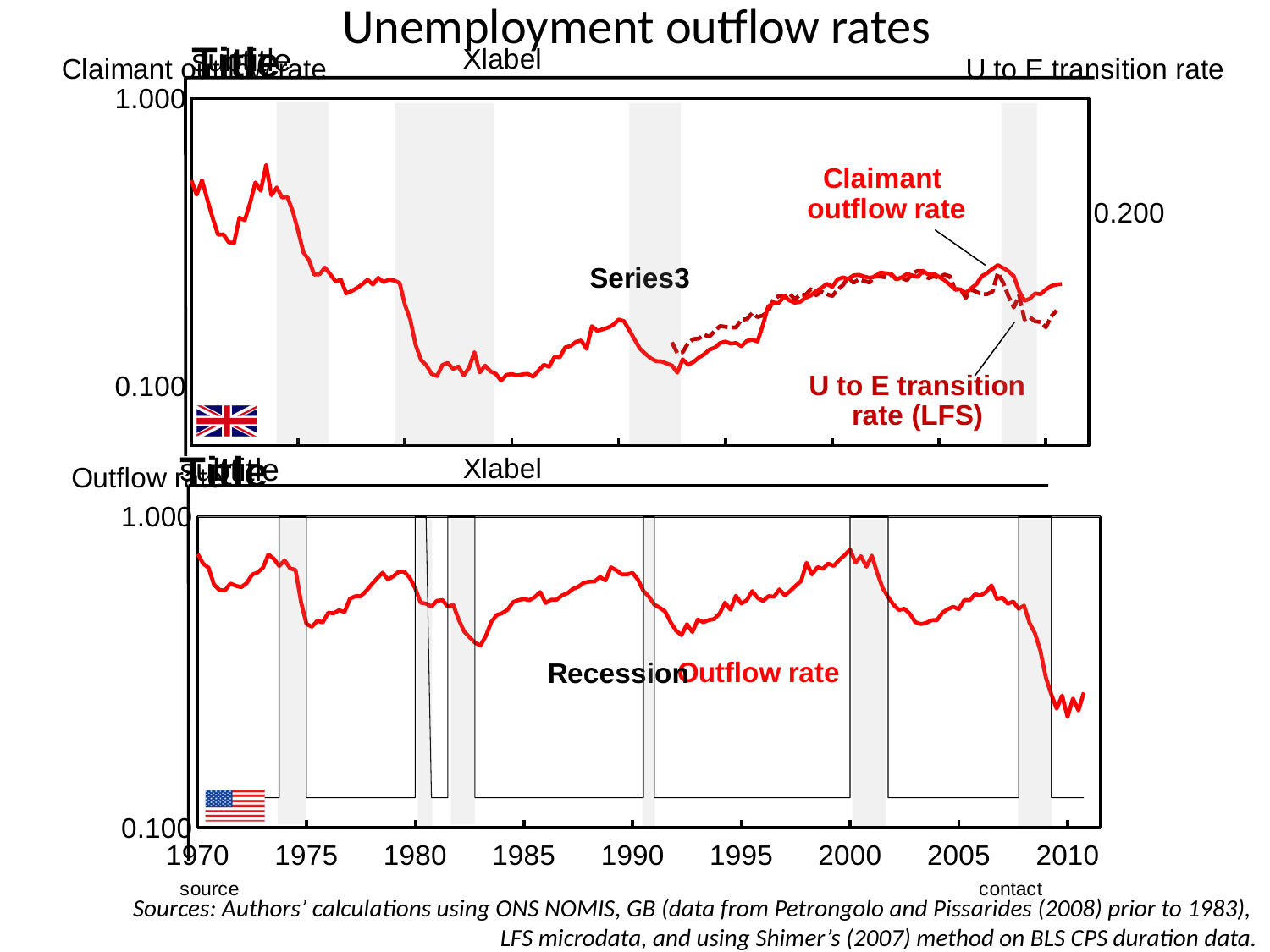
In the bottom chart, is the outflow rate in 2000 greater or less than 0.100? greater What is the title of the slide's charts? Unemployment outflow rates How many year labels are shown on the x axis of the bottom chart? 9 In the top chart, is the claimant outflow rate in 1970 greater or less than 0.100? greater In the top chart, does the claimant outflow rate rise or fall between 1970 and 1985? fall In the top chart, what is the label of the dashed line? U to E transition rate (LFS) What kind of chart is the bottom chart (US) on the slide? line chart What kind of chart is the top chart (UK) on the slide? line chart In the bottom chart, does the outflow rate rise or fall between 2007 and 2009? fall In the top chart, which is larger: the claimant outflow rate in 1970 or in 1985? 1970 In the bottom chart, is the outflow rate in 2010 greater or less than 1.000? less In the bottom chart, which is larger: the outflow rate in 2000 or in 2010? 2000